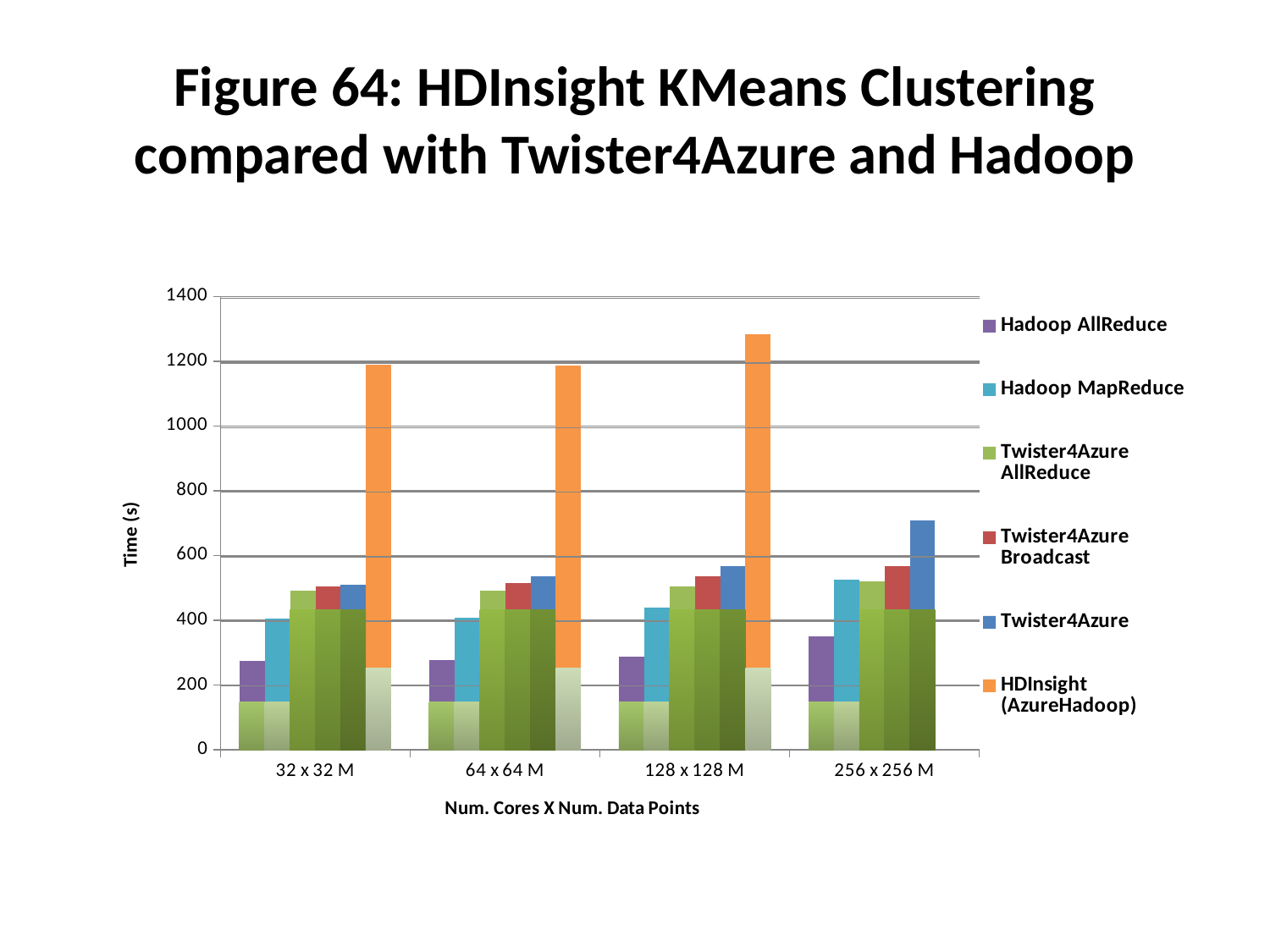
At 64 x 64 M, which is larger: Hadoop MapReduce or Hadoop AllReduce? Hadoop MapReduce Which series has the lowest value at 128 x 128 M? Hadoop AllReduce For which category is the HDInsight (AzureHadoop) bar the tallest? 128 x 128 M Is the value for HDInsight (AzureHadoop) at 128 x 128 M greater or less than 1200? greater How many series does the legend list? 6 Is the value for Hadoop AllReduce at 32 x 32 M greater or less than 400? less What is the title of the y axis? Time (s) Do the values for Twister4Azure rise or fall from 32 x 32 M to 256 x 256 M? rise How many categories are shown on the x axis? 4 What kind of chart is shown on the slide? bar chart Which series has the highest value at 32 x 32 M? HDInsight (AzureHadoop) Is the value for Twister4Azure at 256 x 256 M greater or less than 600? greater